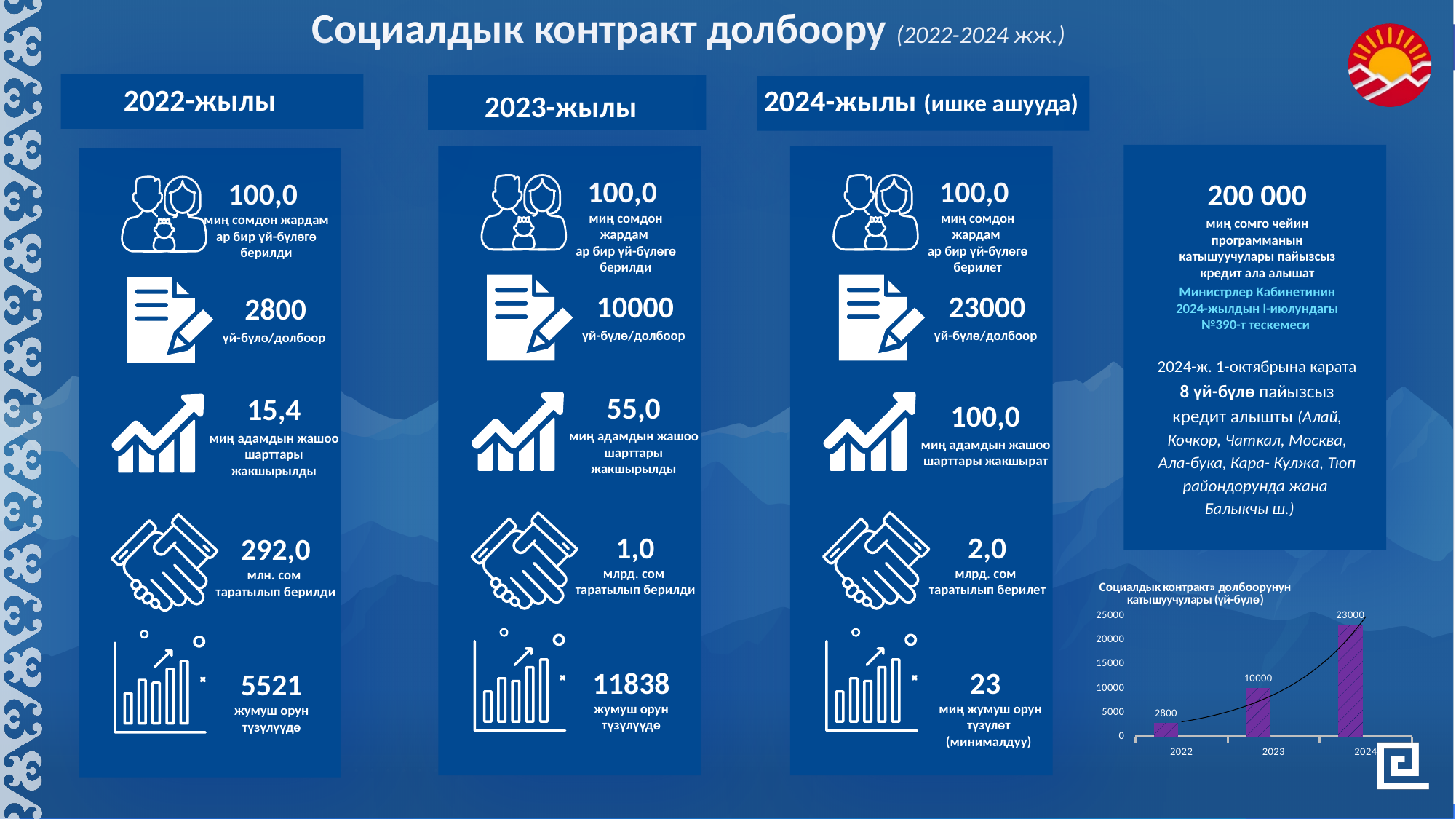
In the bar chart at the bottom right, what is the value for 2022? 2800 In the bar chart at the bottom right, do the values rise or fall from 2022 to 2024? rise In the bar chart at the bottom right, which year has the lowest value? 2022 In the bar chart at the bottom right, what is the difference between the values for 2023 and 2022? 7200 In the bar chart at the bottom right, what is the difference between the values for 2024 and 2023? 13000 In the bar chart at the bottom right, which is larger, the value for 2023 or the value for 2022? 2023 In the bar chart at the bottom right, what is the value for 2024? 23000 How many bars are plotted in the bar chart at the bottom right? 3 In the bar chart at the bottom right, is the value for 2024 greater or less than 20000? greater In the bar chart at the bottom right, what is the value for 2023? 10000 What type of chart is shown at the bottom right of the slide? bar chart In the bar chart at the bottom right, which year has the highest value? 2024